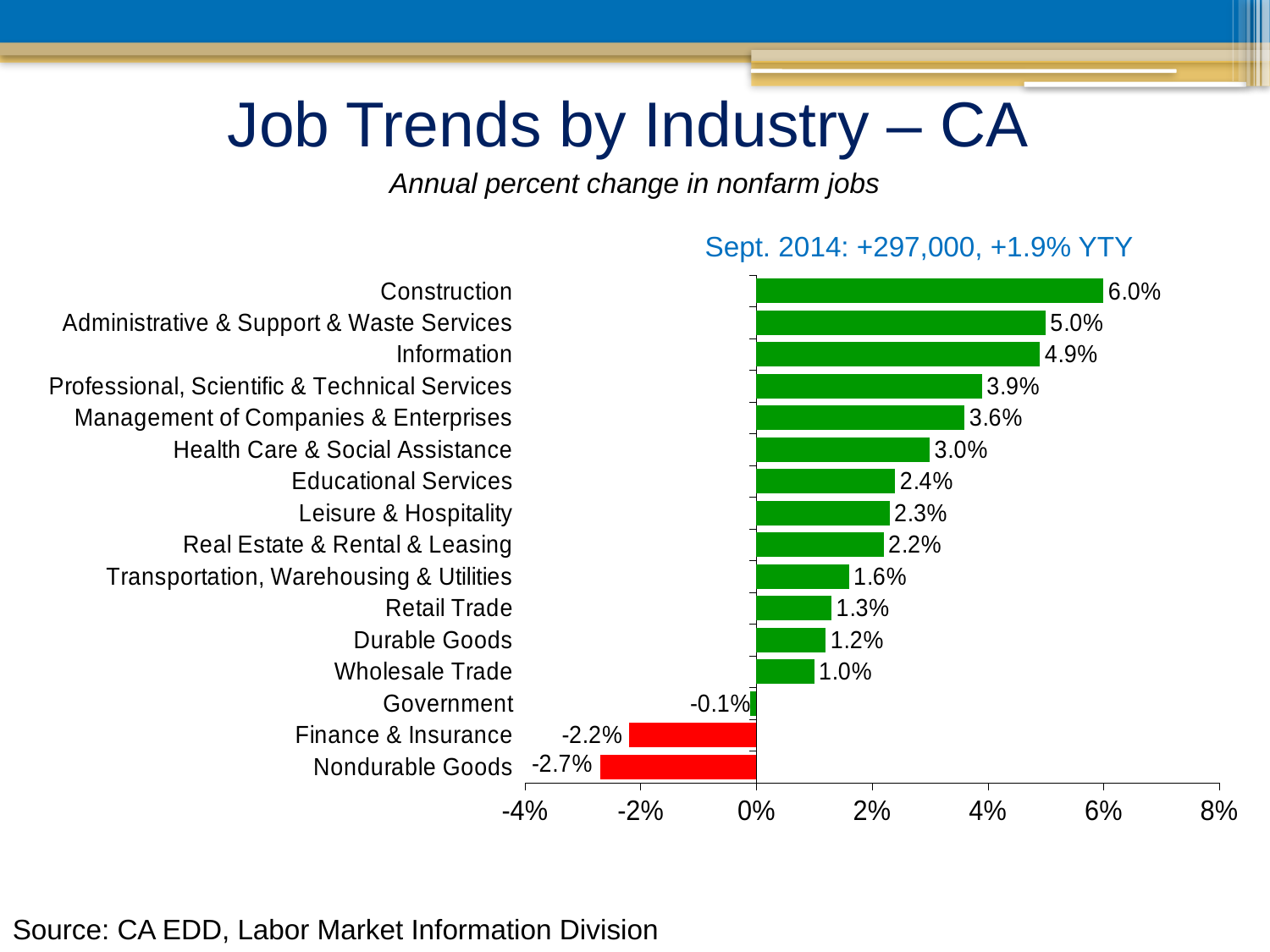
Which is larger, the value for Retail Trade or the value for Wholesale Trade? Retail Trade What is the difference between the values for Construction and Information? 1.1% Which industry has the lowest annual percent change? Nondurable Goods What is the annual percent change in nonfarm jobs for Construction? 6.0% What is the value shown for Health Care & Social Assistance? 3.0% What kind of chart is shown on the slide? Bar chart How many industries are shown in the chart? 16 What is the value shown for Finance & Insurance? -2.2% What colour are the bars for industries with negative values? Red How many industries show a negative annual percent change? 3 Which industry has the highest annual percent change? Construction What is the value shown for Government? -0.1%